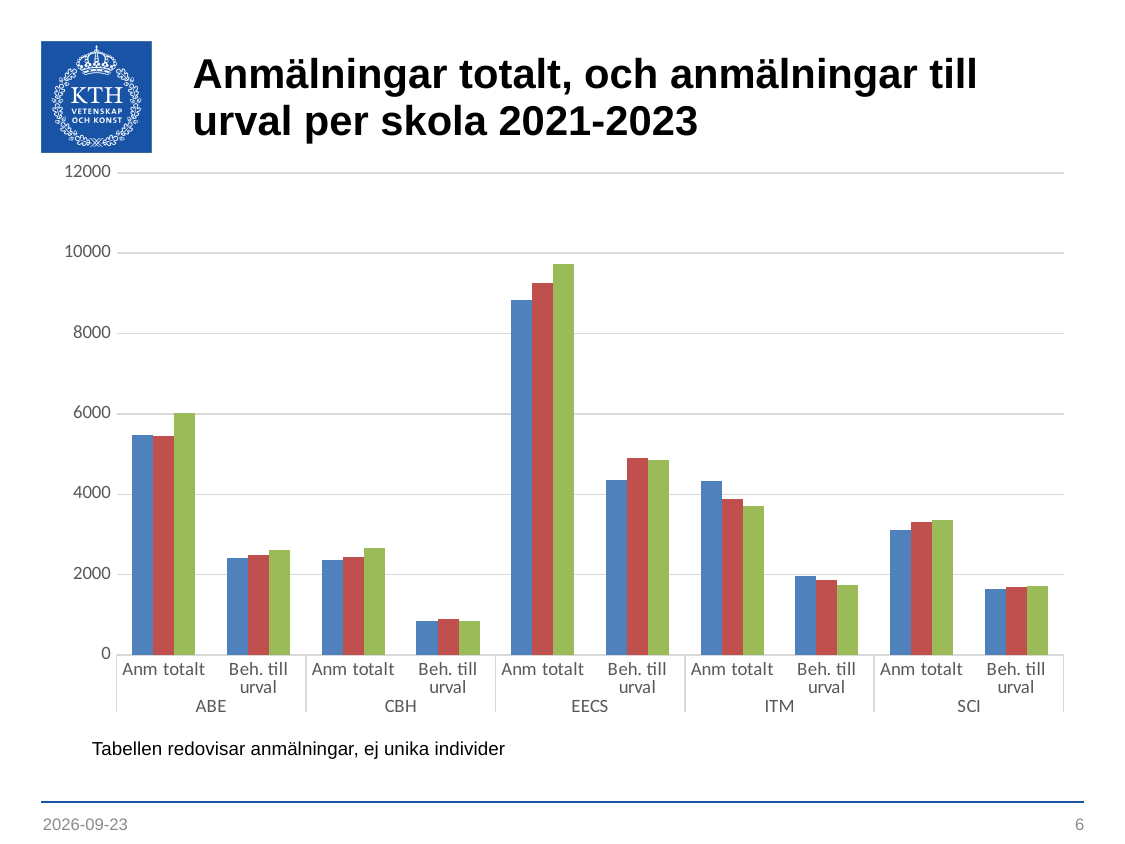
Do the three bars for EECS Anm totalt rise or fall from left to right? rise Which category group has the tallest bars in the chart? EECS Anm totalt Do the three bars for ITM Anm totalt rise or fall from left to right? fall Is the value of the blue bar for ABE Anm totalt greater or less than 4000? greater Which category group has the shortest bars in the chart? CBH Beh. till urval Is the value of the green bar for EECS Anm totalt greater or less than 8000? greater Is the value of the red bar for CBH Beh. till urval greater or less than 2000? less What kind of chart is shown on the slide? bar chart Which is larger, the blue bar for EECS Anm totalt or the blue bar for ITM Anm totalt? EECS Anm totalt What is the title of the chart? Anmälningar totalt, och anmälningar till urval per skola 2021-2023 How many schools are shown along the x axis of the chart? 5